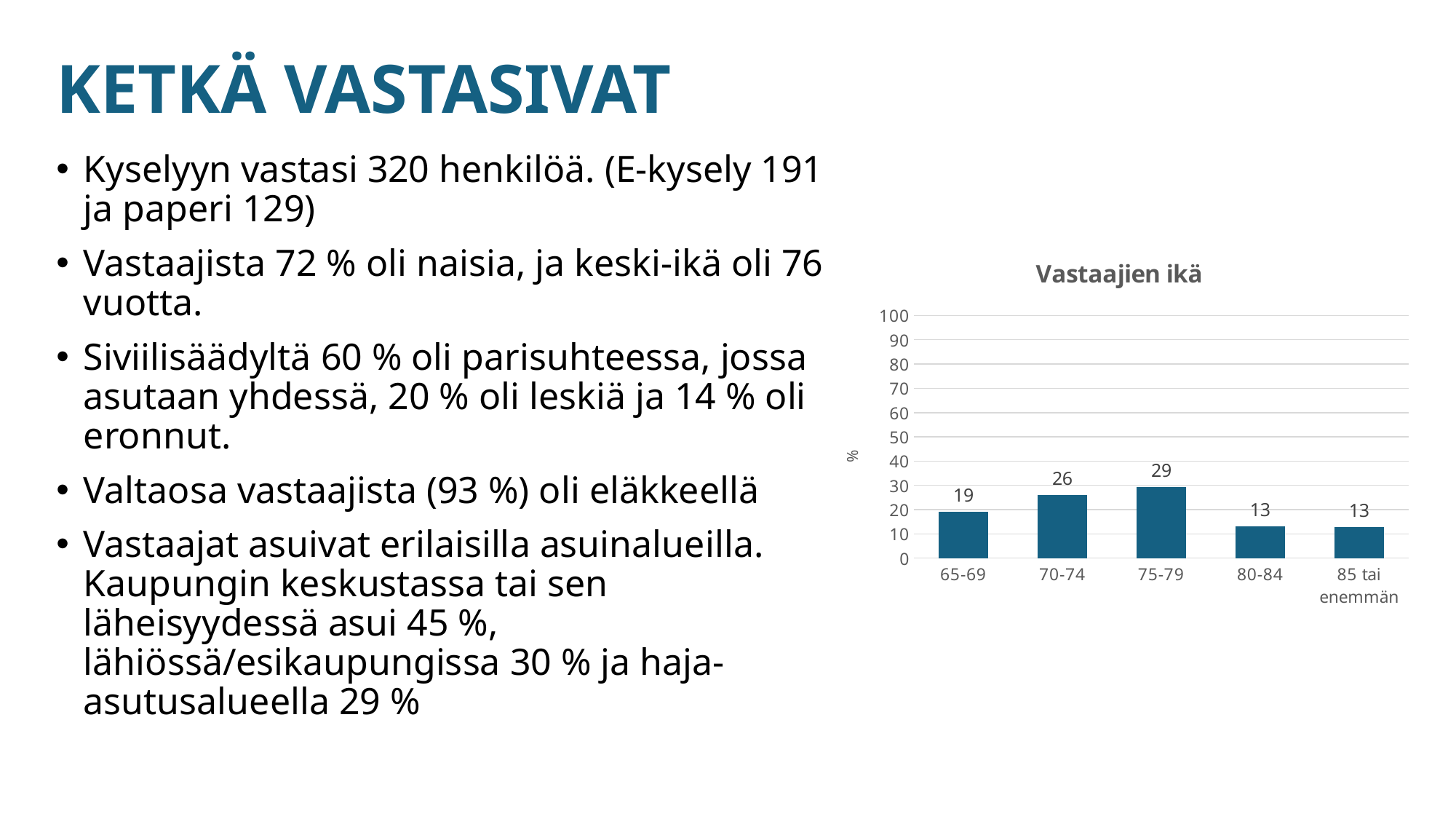
What is the value for the 80-84 age group? 13 What is the title of the chart? Vastaajien ikä Is the value for 75-79 greater or less than 20? greater What is the label on the vertical axis of the chart? % Which age group has the highest value? 75-79 Which is larger, the value for 70-74 or the value for 65-69? 70-74 What is the value for the 75-79 age group? 29 What is the difference between the values for 75-79 and 65-69? 10 What kind of chart is shown on the slide? bar chart What is the difference between the values for 70-74 and 80-84? 13 What is the value for the 65-69 age group? 19 How many age groups are shown in the chart? 5